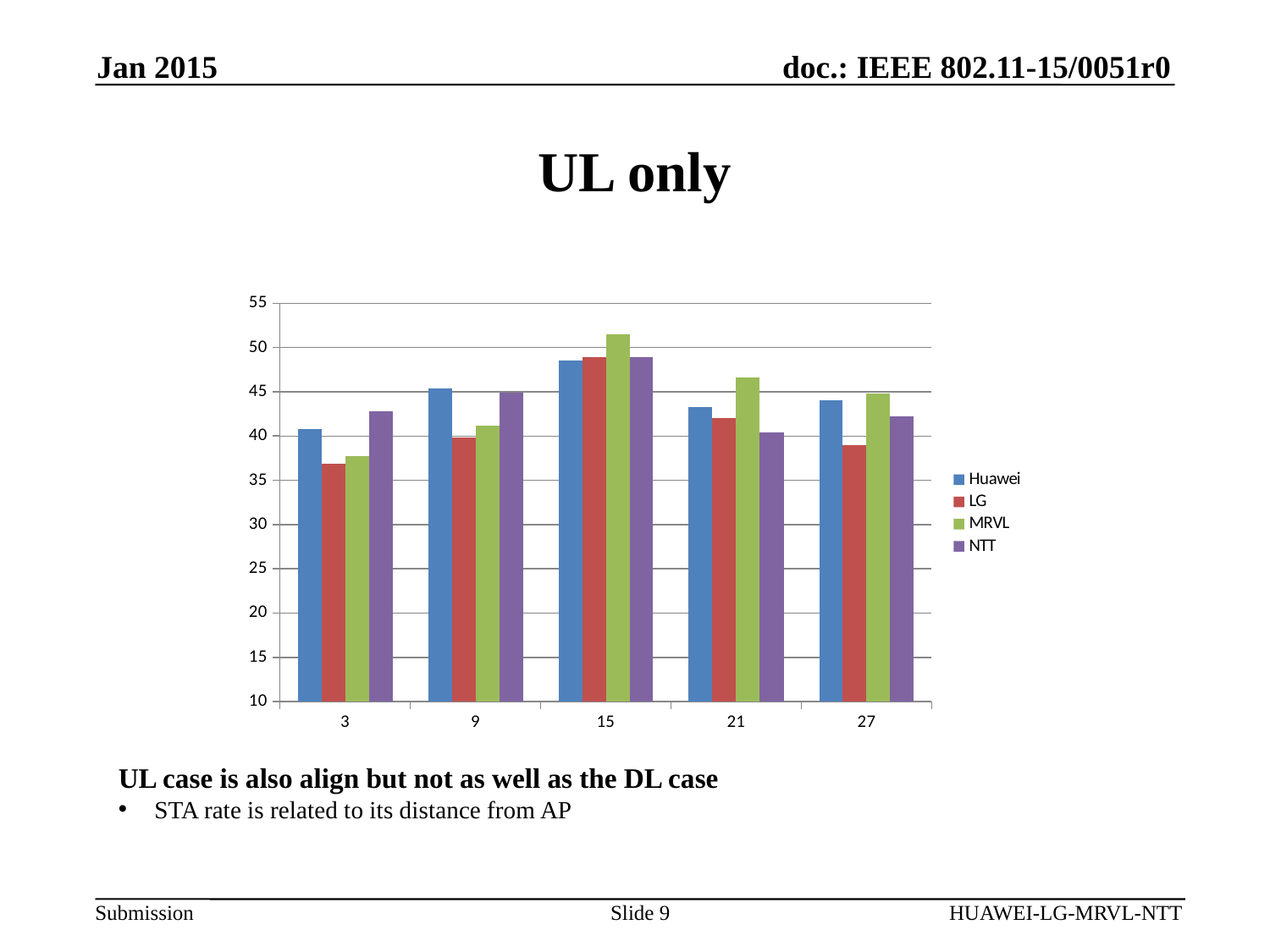
What is the title of the chart on the slide? UL only How many series does the chart's legend list? 4 Is the value for LG at category 3 greater or less than 40? less Is the value for NTT at category 21 greater or less than 45? less Which series is shown in green in the chart's legend? MRVL At category 21, which is larger, the value for MRVL or the value for NTT? MRVL Which series has the highest value at category 15? MRVL Is the value for MRVL at category 15 greater or less than 50? greater How many categories are shown along the x axis of the chart? 5 Which series has the lowest value at category 9? LG What kind of chart is shown on the slide? bar chart